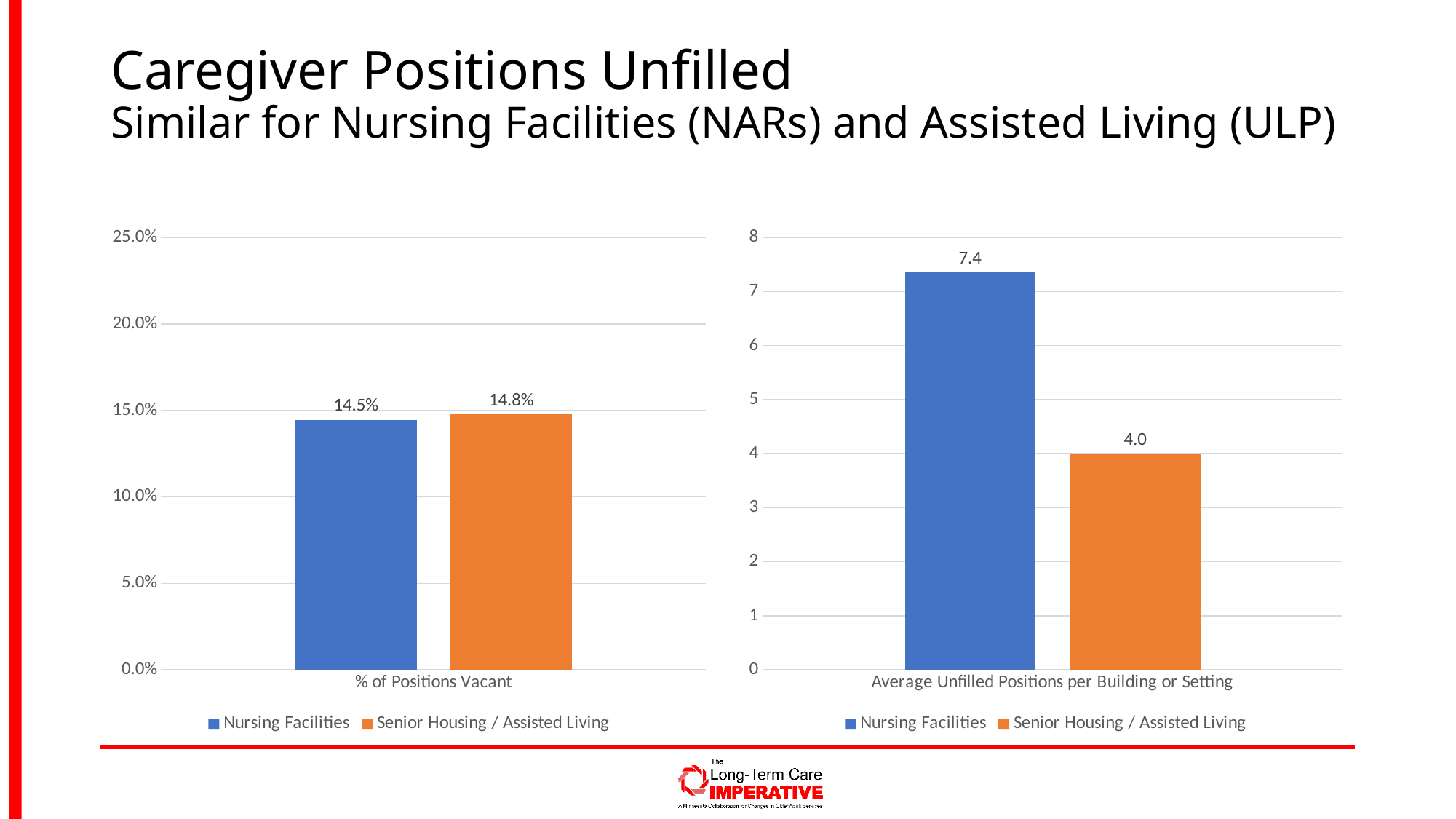
In the right chart (Average Unfilled Positions per Building or Setting), what is the value for Nursing Facilities? 7.4 In the left chart (% of Positions Vacant), is the value for Nursing Facilities greater or less than 10.0%? greater What kind of chart is the right chart (Average Unfilled Positions per Building or Setting)? bar chart In the left chart (% of Positions Vacant), what colour is the bar for Senior Housing / Assisted Living? orange In the right chart (Average Unfilled Positions per Building or Setting), is the value for Senior Housing / Assisted Living greater or less than 5? less In the right chart (Average Unfilled Positions per Building or Setting), what is the value for Senior Housing / Assisted Living? 4.0 In the left chart (% of Positions Vacant), what is the difference between the Senior Housing / Assisted Living and Nursing Facilities values? 0.3% In the right chart (Average Unfilled Positions per Building or Setting), which series has the higher value? Nursing Facilities In the left chart (% of Positions Vacant), what is the value for Senior Housing / Assisted Living? 14.8% In the right chart (Average Unfilled Positions per Building or Setting), what is the difference between the Nursing Facilities and Senior Housing / Assisted Living values? 3.4 How many series does the legend of the left chart (% of Positions Vacant) list? 2 In the left chart (% of Positions Vacant), what is the value for Nursing Facilities? 14.5%